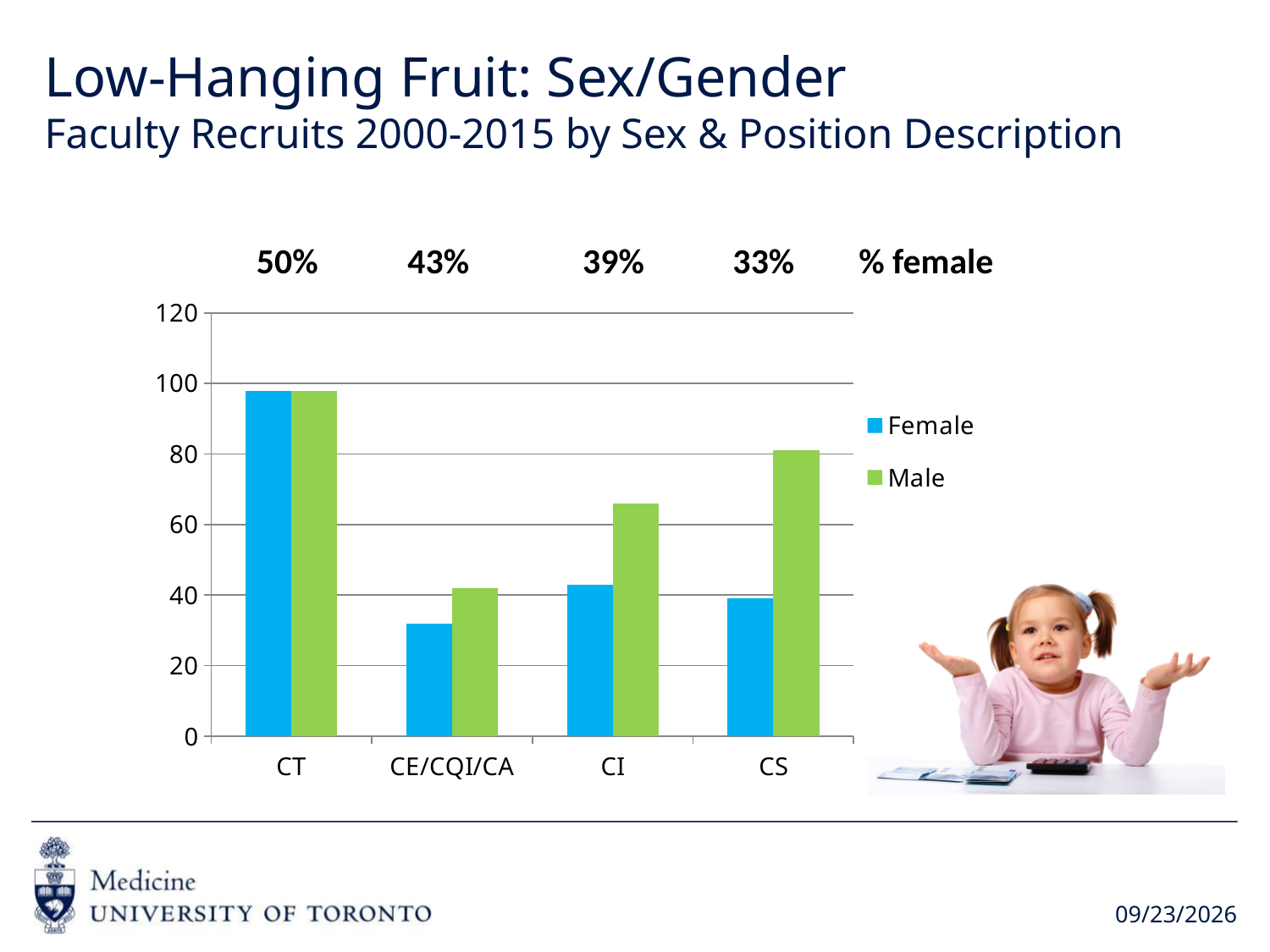
How many position description categories are shown on the x axis? 4 Which category has the lowest Male value? CE/CQI/CA Is the Male value for CS greater or less than 60? greater Which category has the lowest Female value? CE/CQI/CA Is the Female value for CT greater or less than 80? greater What % female figure is printed above the CS category? 33% Which category has the highest Male value? CT Is the Female value for CE/CQI/CA greater or less than 40? less How many series does the legend list? 2 What kind of chart is shown on the slide? bar chart Do the % female figures printed above the chart rise or fall from CT to CS? fall For CS, which is larger, the Female value or the Male value? Male